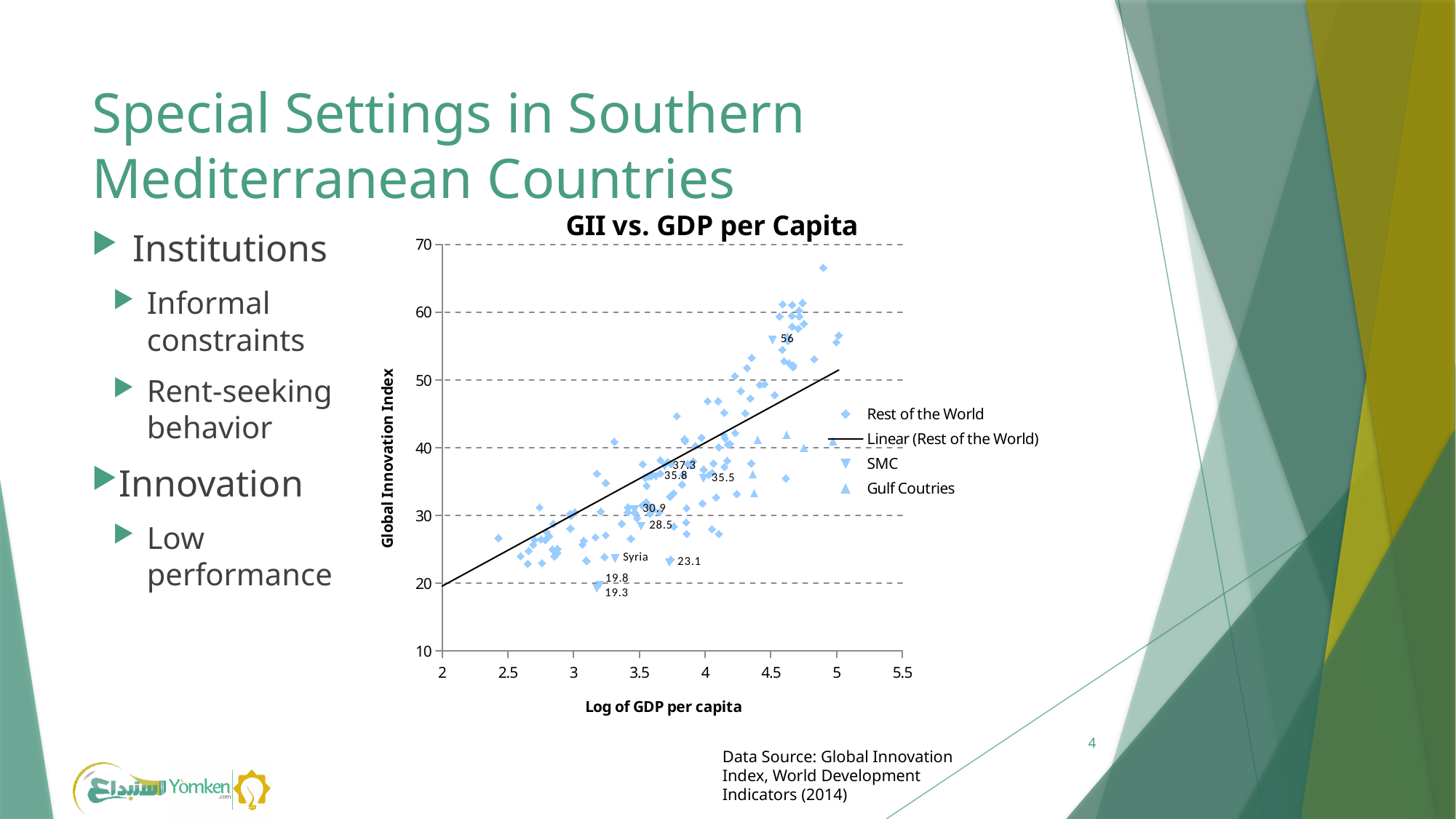
Is the highest labeled SMC value greater or less than 50? greater What is the highest labeled value among the SMC points? 56 What is the title of the chart? GII vs. GDP per Capita What is the difference between the SMC points labeled 37.3 and 35.8? 1.5 What kind of chart is shown on the slide? Scatter chart Do the Global Innovation Index values generally rise or fall as Log of GDP per capita increases? rise Is the SMC point labeled Syria greater or less than 30 on the Global Innovation Index? less What is the lowest labeled value among the SMC points? 19.3 How many entries does the chart's legend list? 4 Which is larger, the SMC point labeled 30.9 or the one labeled 28.5? 30.9 How many SMC points carry a numeric data label? 9 What is the label of the chart's vertical axis? Global Innovation Index